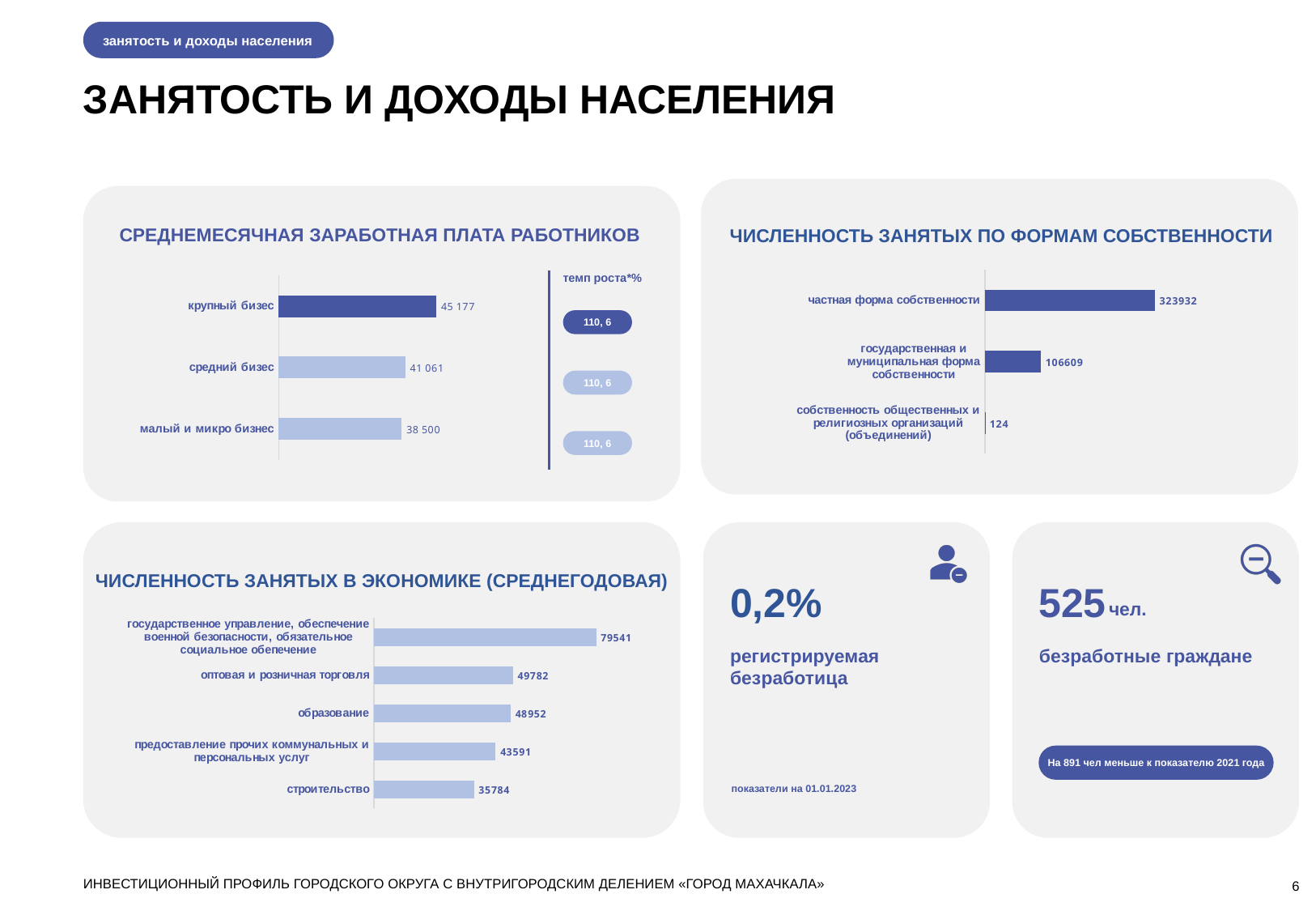
In the chart 'ЧИСЛЕННОСТЬ ЗАНЯТЫХ ПО ФОРМАМ СОБСТВЕННОСТИ', what is the difference between 'частная форма собственности' and 'государственная и муниципальная форма собственности'? 217323 In the chart 'СРЕДНЕМЕСЯЧНАЯ ЗАРАБОТНАЯ ПЛАТА РАБОТНИКОВ', what is the difference between 'крупный бизнес' and 'средний бизнес'? 4 116 In the chart 'ЧИСЛЕННОСТЬ ЗАНЯТЫХ ПО ФОРМАМ СОБСТВЕННОСТИ', what is the value for 'государственная и муниципальная форма собственности'? 106609 In the chart 'ЧИСЛЕННОСТЬ ЗАНЯТЫХ В ЭКОНОМИКЕ (СРЕДНЕГОДОВАЯ)', which is larger: 'оптовая и розничная торговля' or 'образование'? оптовая и розничная торговля In the chart 'ЧИСЛЕННОСТЬ ЗАНЯТЫХ ПО ФОРМАМ СОБСТВЕННОСТИ', which category has the highest value? частная форма собственности In the chart 'СРЕДНЕМЕСЯЧНАЯ ЗАРАБОТНАЯ ПЛАТА РАБОТНИКОВ', what is the value for 'крупный бизнес'? 45 177 In the chart 'ЧИСЛЕННОСТЬ ЗАНЯТЫХ В ЭКОНОМИКЕ (СРЕДНЕГОДОВАЯ)', what is the value for 'строительство'? 35784 In the chart 'СРЕДНЕМЕСЯЧНАЯ ЗАРАБОТНАЯ ПЛАТА РАБОТНИКОВ', how many categories are shown? 3 In the chart 'ЧИСЛЕННОСТЬ ЗАНЯТЫХ В ЭКОНОМИКЕ (СРЕДНЕГОДОВАЯ)', what is the difference between the highest and lowest values? 43757 In the chart 'СРЕДНЕМЕСЯЧНАЯ ЗАРАБОТНАЯ ПЛАТА РАБОТНИКОВ', which category has the lowest value? малый и микро бизнес What kind of chart is 'ЧИСЛЕННОСТЬ ЗАНЯТЫХ ПО ФОРМАМ СОБСТВЕННОСТИ'? bar chart In the chart 'ЧИСЛЕННОСТЬ ЗАНЯТЫХ В ЭКОНОМИКЕ (СРЕДНЕГОДОВАЯ)', how many categories are shown? 5